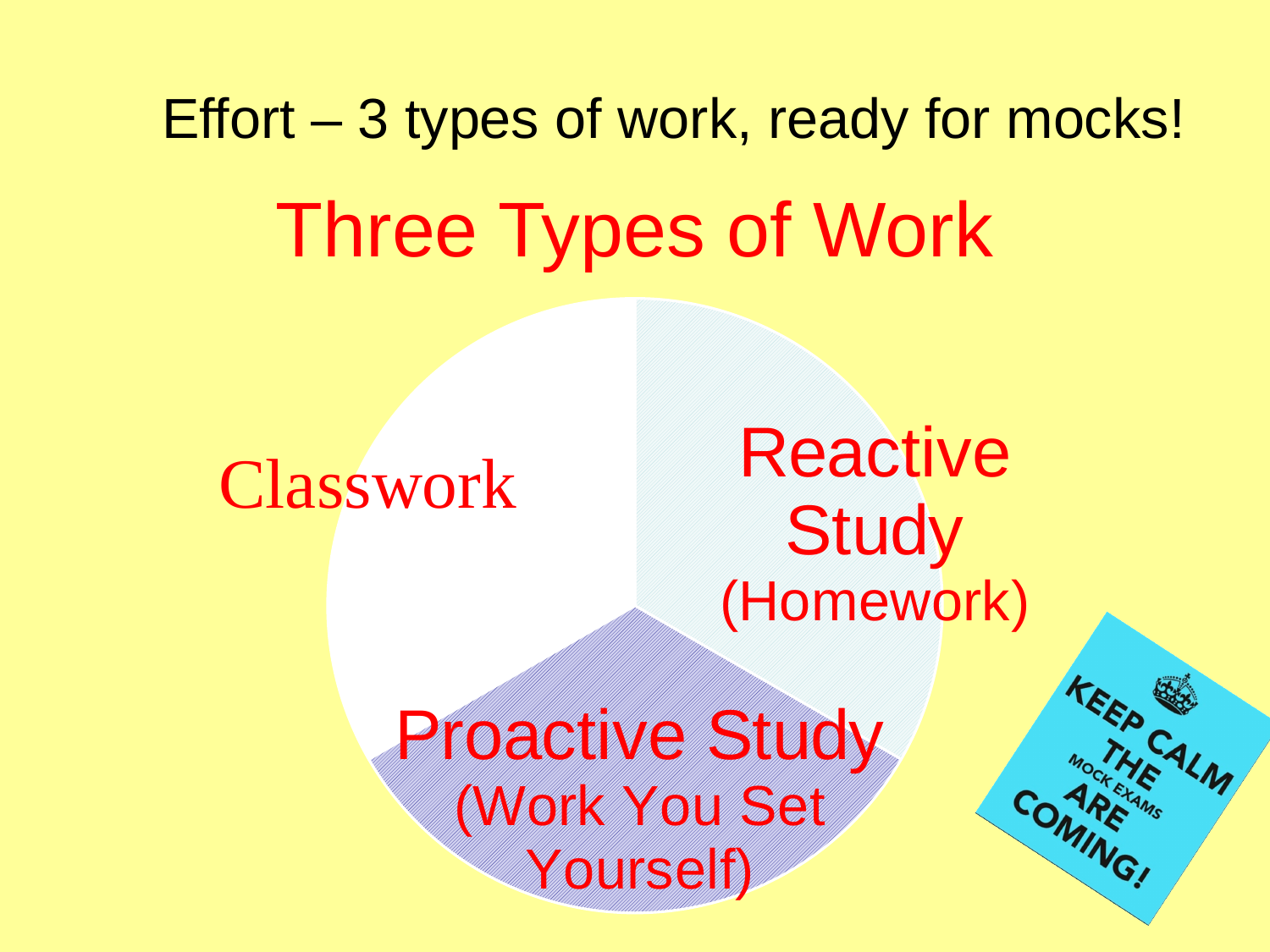
What is written in brackets under the 'Proactive Study' label on the pie chart? (Work You Set Yourself) How many slices does the pie chart have? 3 What is the title of the pie chart? Three Types of Work Which slice of the pie chart is at the bottom? Proactive Study Which slice of the pie chart is white? Classwork What kind of chart is shown on the slide? pie chart